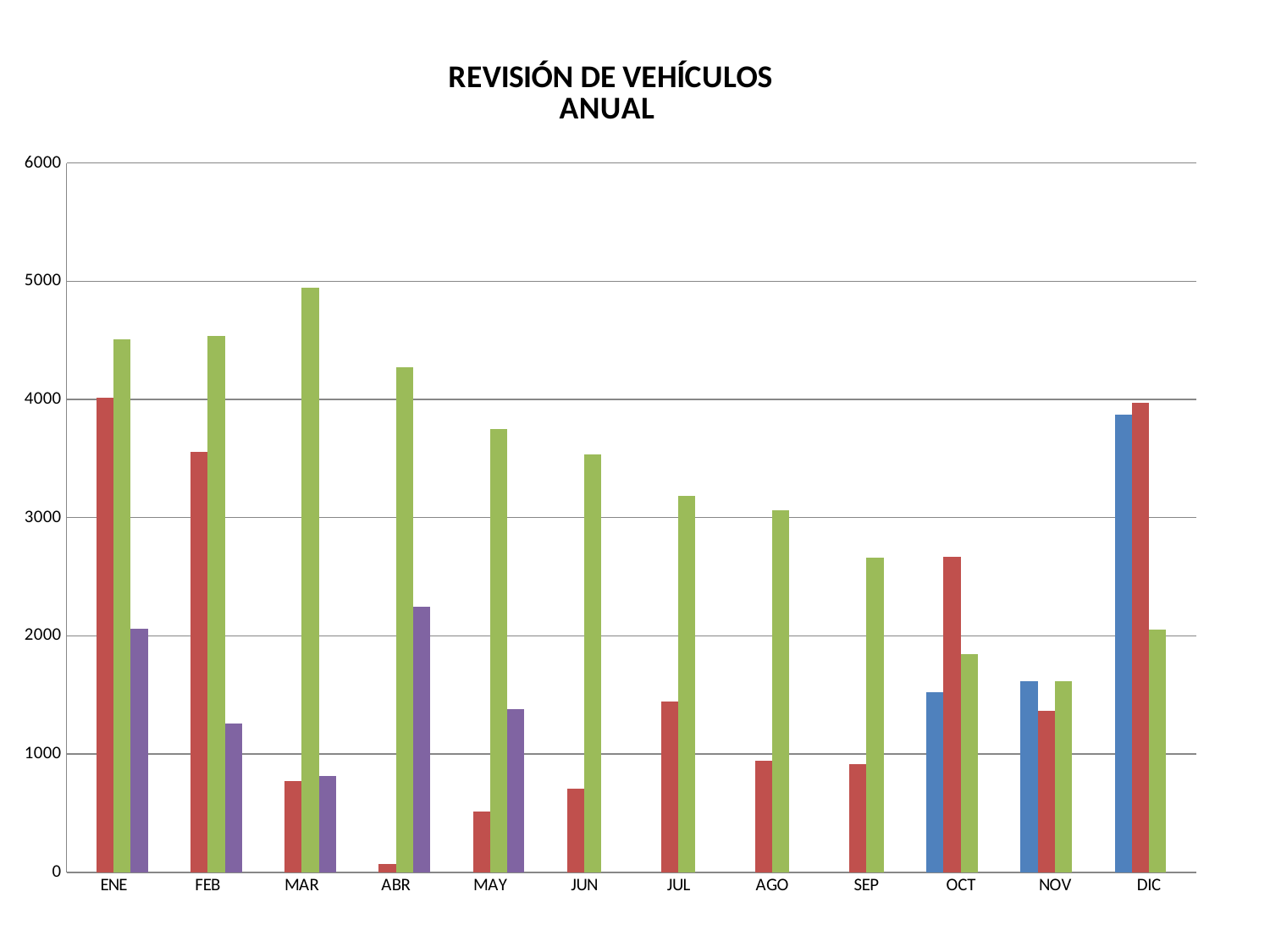
In which month is the red bar the lowest? ABR How many months are shown on the x axis of the chart? 12 In which month is the green bar the highest? MAR Is the value of the red bar for ABR greater or less than 1000? less Is the value of the purple bar for ABR greater or less than 2000? greater Is the value of the blue bar for DIC greater or less than 3000? greater In which months does a blue bar appear in the chart? OCT, NOV, DIC Which is larger, the green bar for JUN or the green bar for JUL? JUN Do the green bars rise or fall from MAR to NOV? fall What kind of chart is shown on the slide? bar chart What is the title of the chart? REVISIÓN DE VEHÍCULOS ANUAL